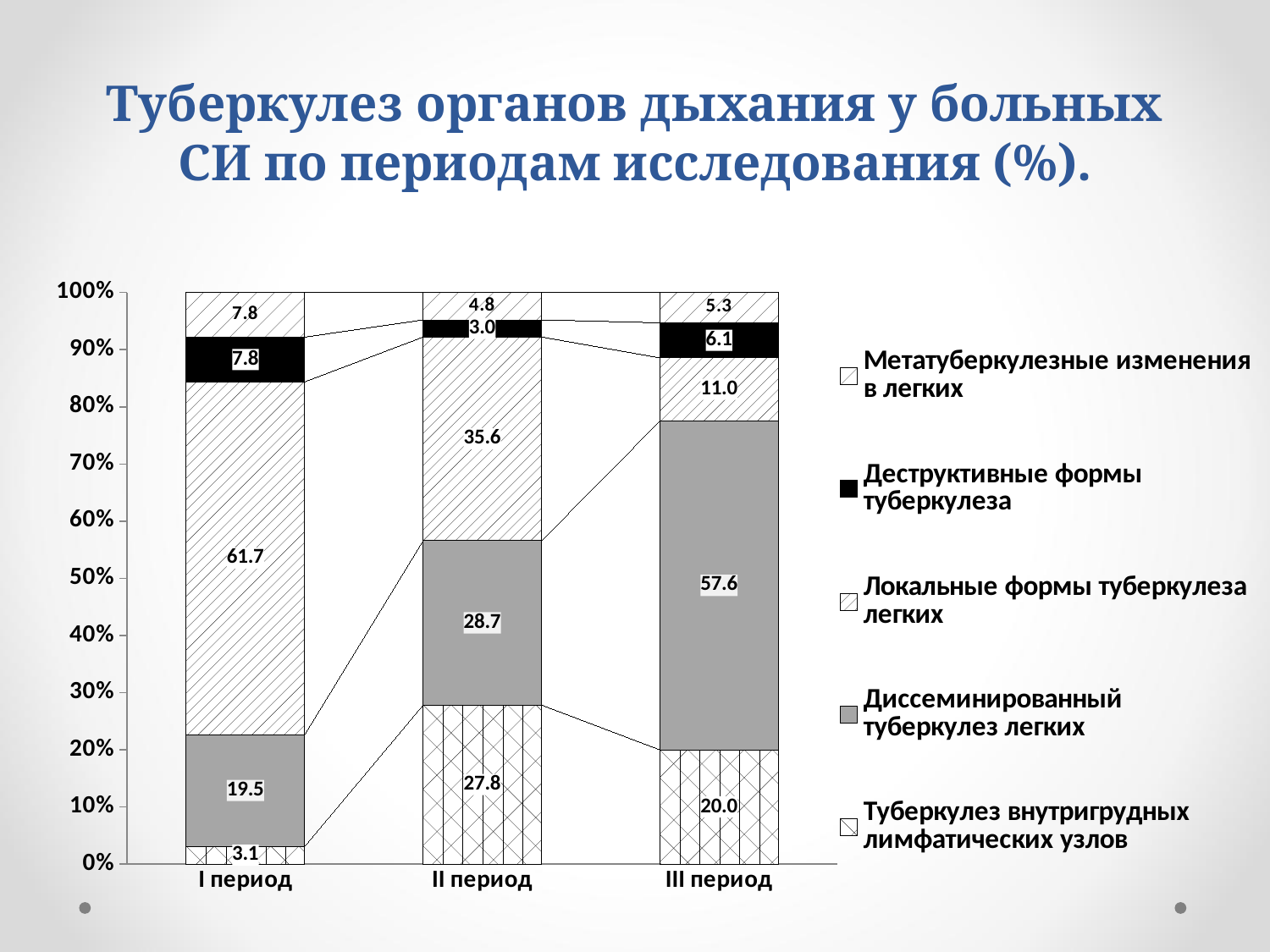
What is the value for Туберкулез внутригрудных лимфатических узлов in III период? 20.0 What is the difference between the Диссеминированный туберкулез легких values in III период and I период? 38.1 What kind of chart is shown on the slide? Stacked bar chart Does the value for Локальные формы туберкулеза легких rise or fall from I период to III период? Fall What is the value for Локальные формы туберкулеза легких in II период? 35.6 In which period is the value for Диссеминированный туберкулез легких highest? III период How many series does the legend list? 5 Which is larger: Деструктивные формы туберкулеза in I период or in III период? I период What is the value for Деструктивные формы туберкулеза in II период? 3.0 How many periods (categories) are shown on the x axis? 3 What is the value for Диссеминированный туберкулез легких in I период? 19.5 In which period is the value for Туберкулез внутригрудных лимфатических узлов lowest? I период